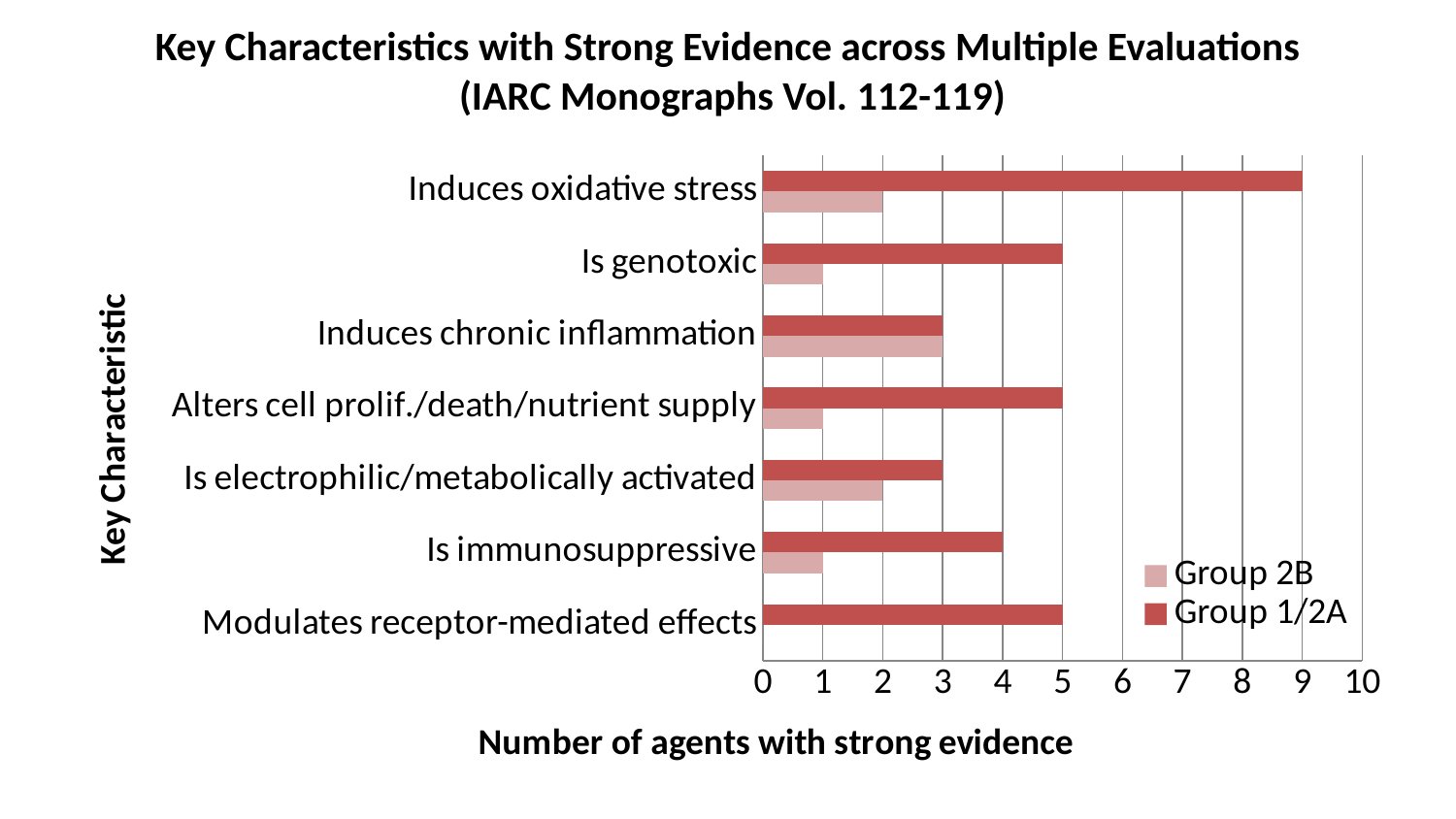
Which key characteristic has the highest Group 1/2A value? Induces oxidative stress What is the difference between the Group 1/2A and Group 2B values for 'Induces oxidative stress'? 7 What is the Group 2B value for 'Induces chronic inflammation'? 3 How many key characteristics are plotted on the chart? 7 What type of chart is shown on the slide? bar chart Is the Group 1/2A value for 'Modulates receptor-mediated effects' greater or less than 4? greater What is the Group 1/2A value for 'Is immunosuppressive'? 4 What is the Group 1/2A value for 'Induces oxidative stress'? 9 What is the label of the x axis? Number of agents with strong evidence How many series does the legend list? 2 Which is larger for 'Is genotoxic': the Group 1/2A value or the Group 2B value? Group 1/2A Which key characteristic has the highest Group 2B value? Induces chronic inflammation